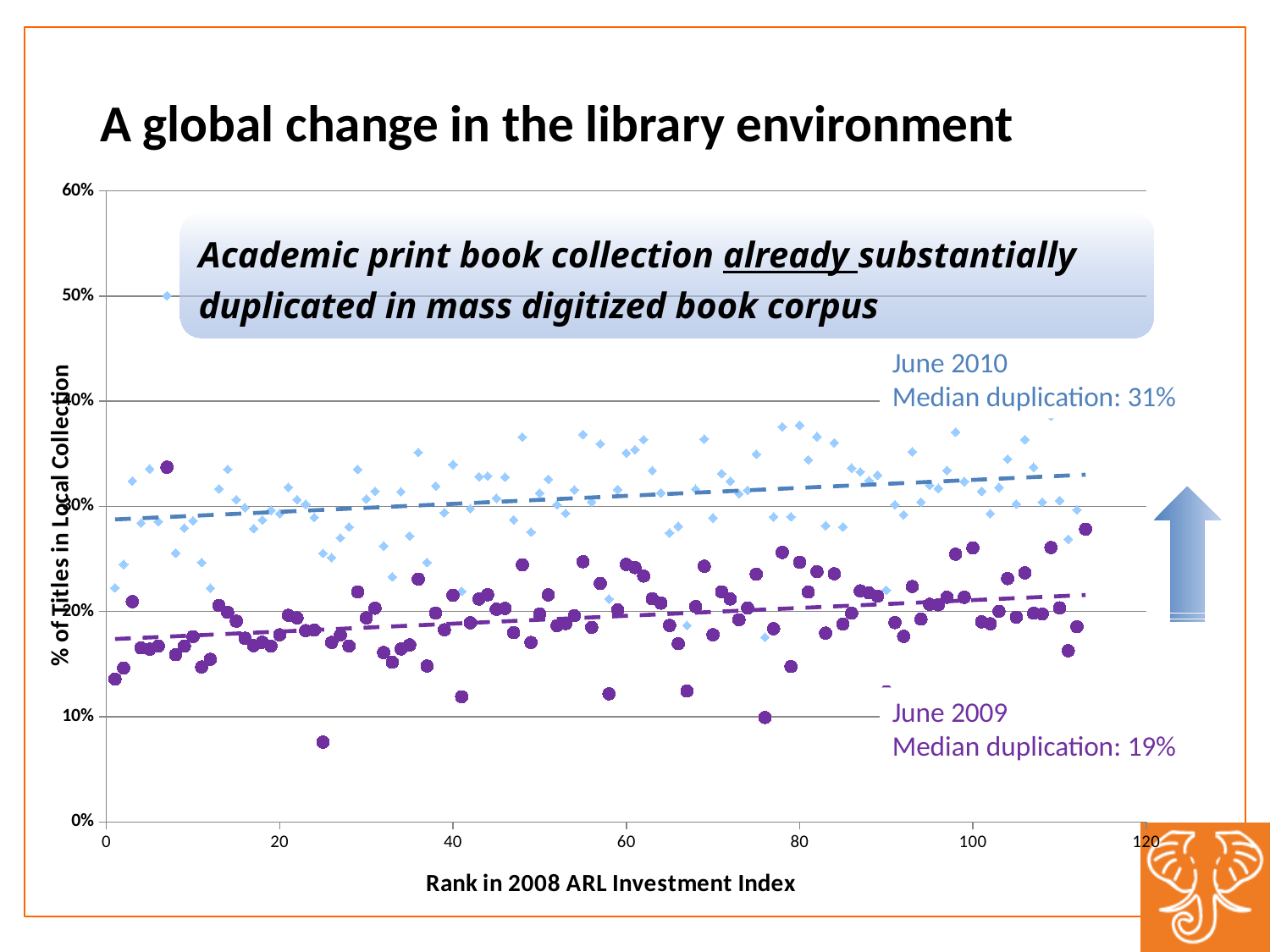
What is the difference between the June 2010 median duplication and the June 2009 median duplication? 12% Which series has the higher median duplication, June 2010 or June 2009? June 2010 What kind of chart is shown on the slide? scatter chart What is the label of the y axis? % of Titles in Local Collection What is the median duplication for June 2010? 31% Is the June 2009 median duplication greater or less than 20%? less How many data series are plotted on the chart? 2 Is the June 2010 median duplication greater or less than 30%? greater What is the label of the x axis? Rank in 2008 ARL Investment Index Do the dashed trend lines rise or fall as rank increases along the x axis? rise What is the median duplication for June 2009? 19%